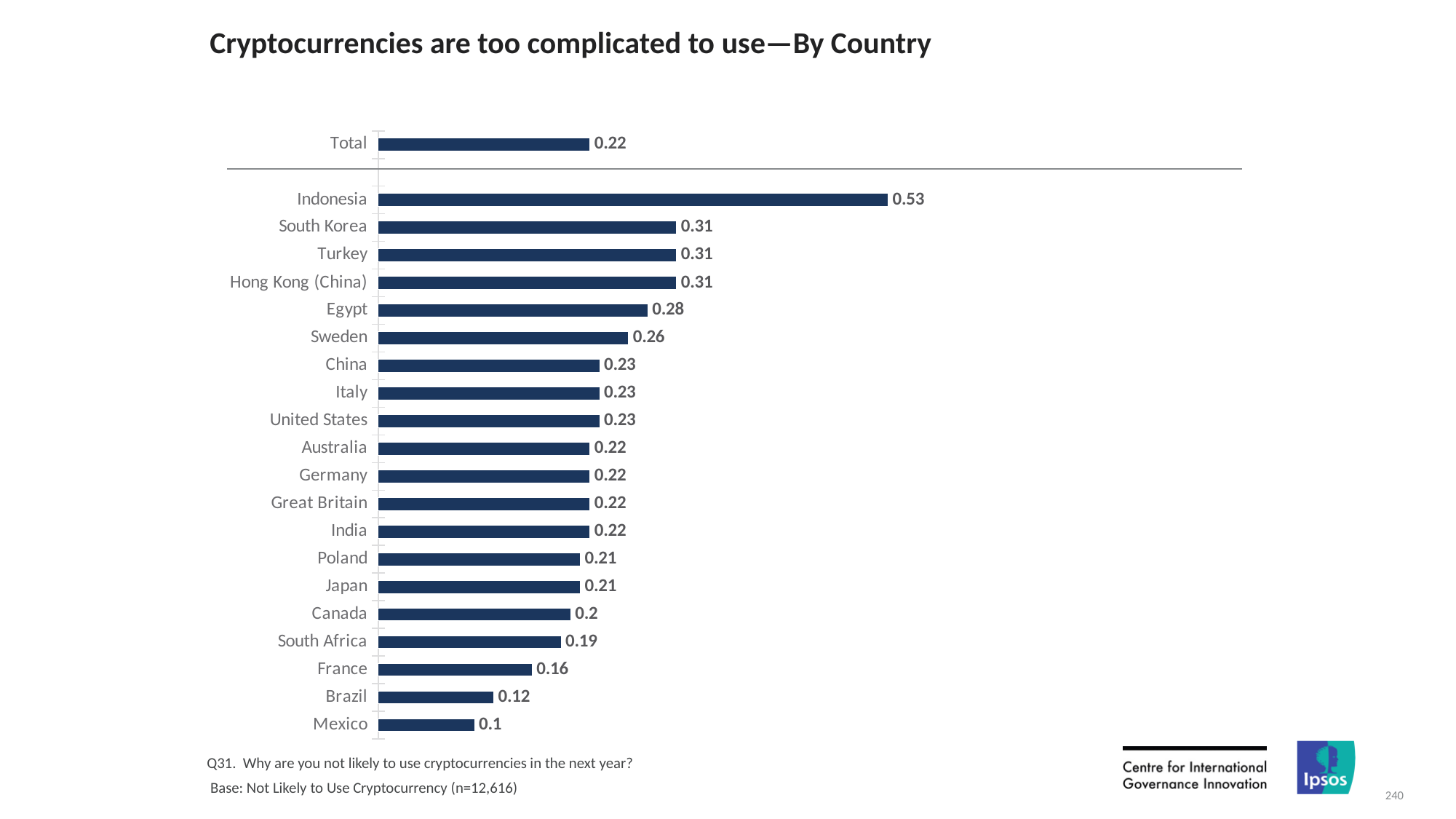
What is the title of the chart? Cryptocurrencies are too complicated to use—By Country What is the value for France? 0.16 What is the difference between the values for Indonesia and Mexico? 0.43 What is the value for Total? 0.22 What is the difference between the values for Sweden and Brazil? 0.14 What kind of chart is shown on the slide? Bar chart How many countries are listed below the Total bar? 20 Which country has the lowest value? Mexico Which country has the highest value? Indonesia What is the value for Egypt? 0.28 What is the value for Indonesia? 0.53 Which has a larger value, Egypt or Canada? Egypt